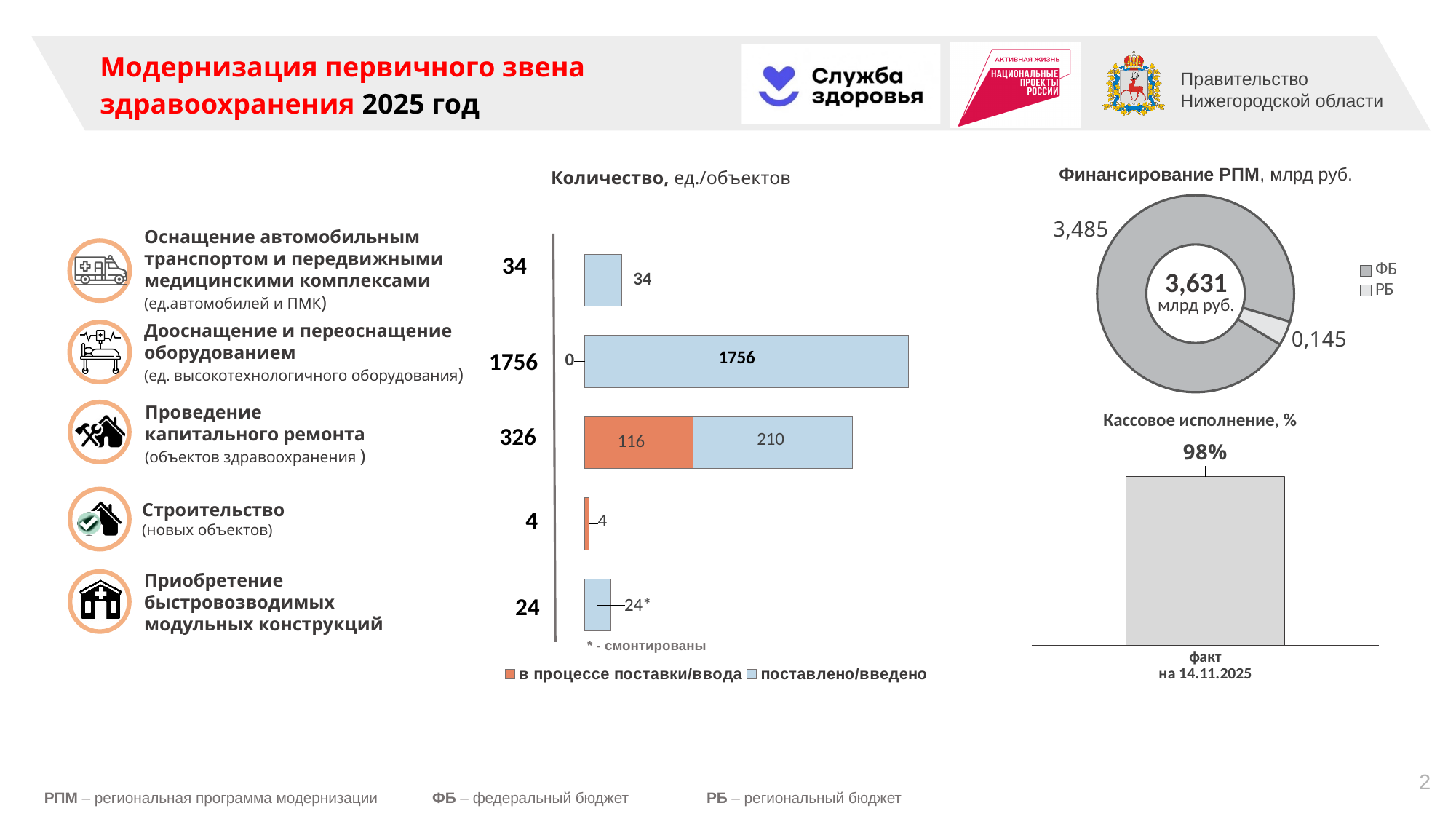
In the chart 'Финансирование РПМ, млрд руб.', what is the value for ФБ? 3,485 In the chart 'Финансирование РПМ, млрд руб.', which is larger, ФБ or РБ? ФБ In the chart 'Количество, ед./объектов', which category has the lowest total value? Строительство In the chart 'Количество, ед./объектов', how many series does the legend list? 2 In the chart 'Количество, ед./объектов', what is the 'поставлено/введено' value for 'Проведение капитального ремонта'? 210 In the chart 'Количество, ед./объектов', what is the total of the stacked bar for 'Проведение капитального ремонта'? 326 In the chart 'Количество, ед./объектов', which category has the highest total value? Дооснащение и переоснащение оборудованием What kind of chart is 'Количество, ед./объектов'? Bar chart In the chart 'Финансирование РПМ, млрд руб.', what is the value for РБ? 0,145 In the chart 'Количество, ед./объектов', what is the 'в процессе поставки/ввода' value for 'Проведение капитального ремонта'? 116 In the chart 'Количество, ед./объектов', how many categories are shown? 5 In the chart 'Кассовое исполнение, %', what is the value for 'факт на 14.11.2025'? 98%